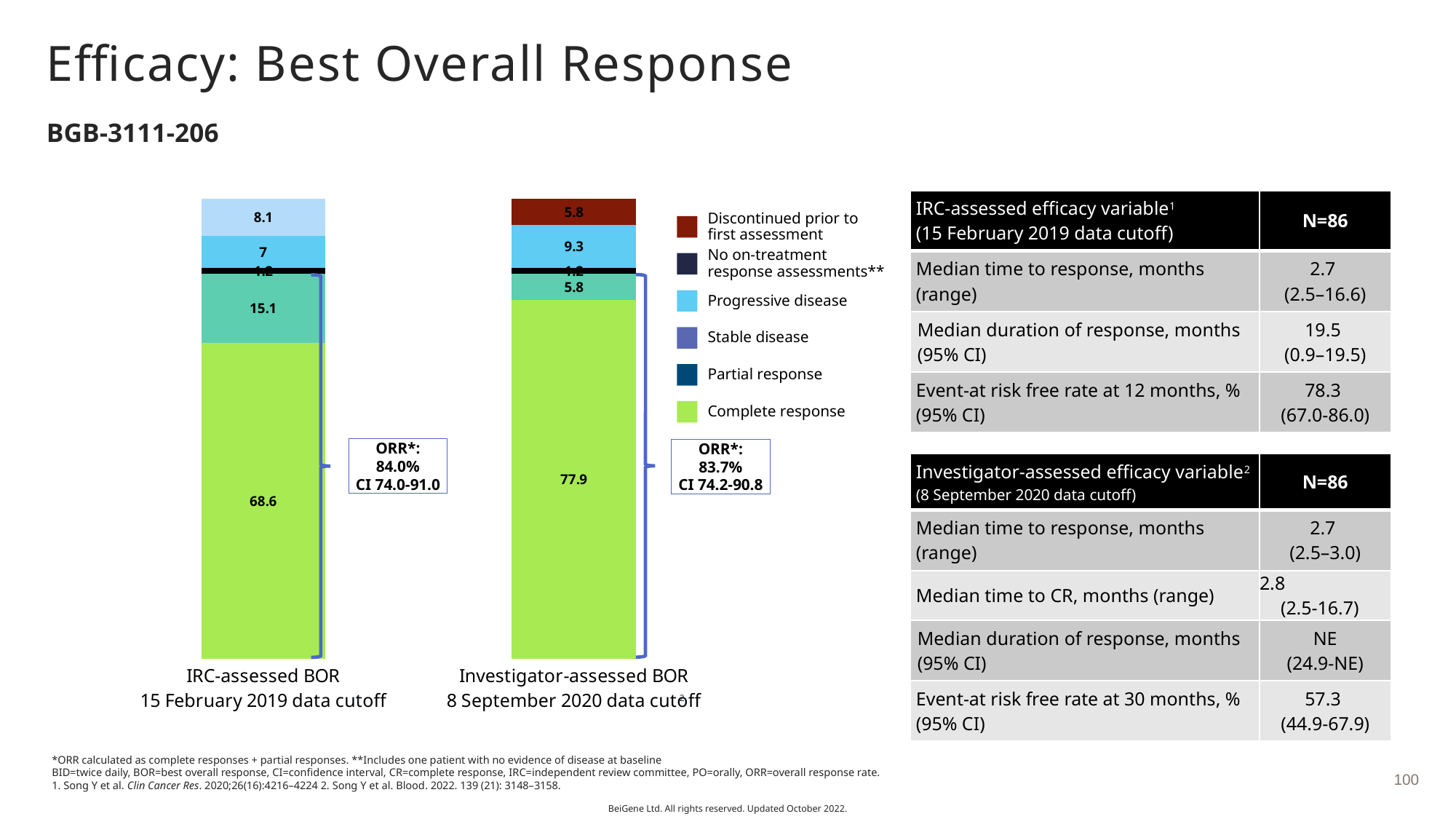
What is the value of the topmost segment of the Investigator-assessed BOR bar? 5.8 What ORR is shown for the IRC-assessed BOR bar? 84.0% What is the value of the topmost segment of the IRC-assessed BOR bar? 8.1 Which bar has the larger complete response segment, IRC-assessed BOR or Investigator-assessed BOR? Investigator-assessed BOR What ORR is shown for the Investigator-assessed BOR bar? 83.7% What is the complete response value (green segment) in the Investigator-assessed BOR bar? 77.9 What kind of chart is shown on the slide? Stacked bar chart How many entries does the chart legend list? 6 What is the difference between the complete response values of the Investigator-assessed BOR bar and the IRC-assessed BOR bar? 9.3 Which legend entry is shown in green? Complete response What is the complete response value (green segment) in the IRC-assessed BOR bar? 68.6 How many bars are plotted in the chart? 2